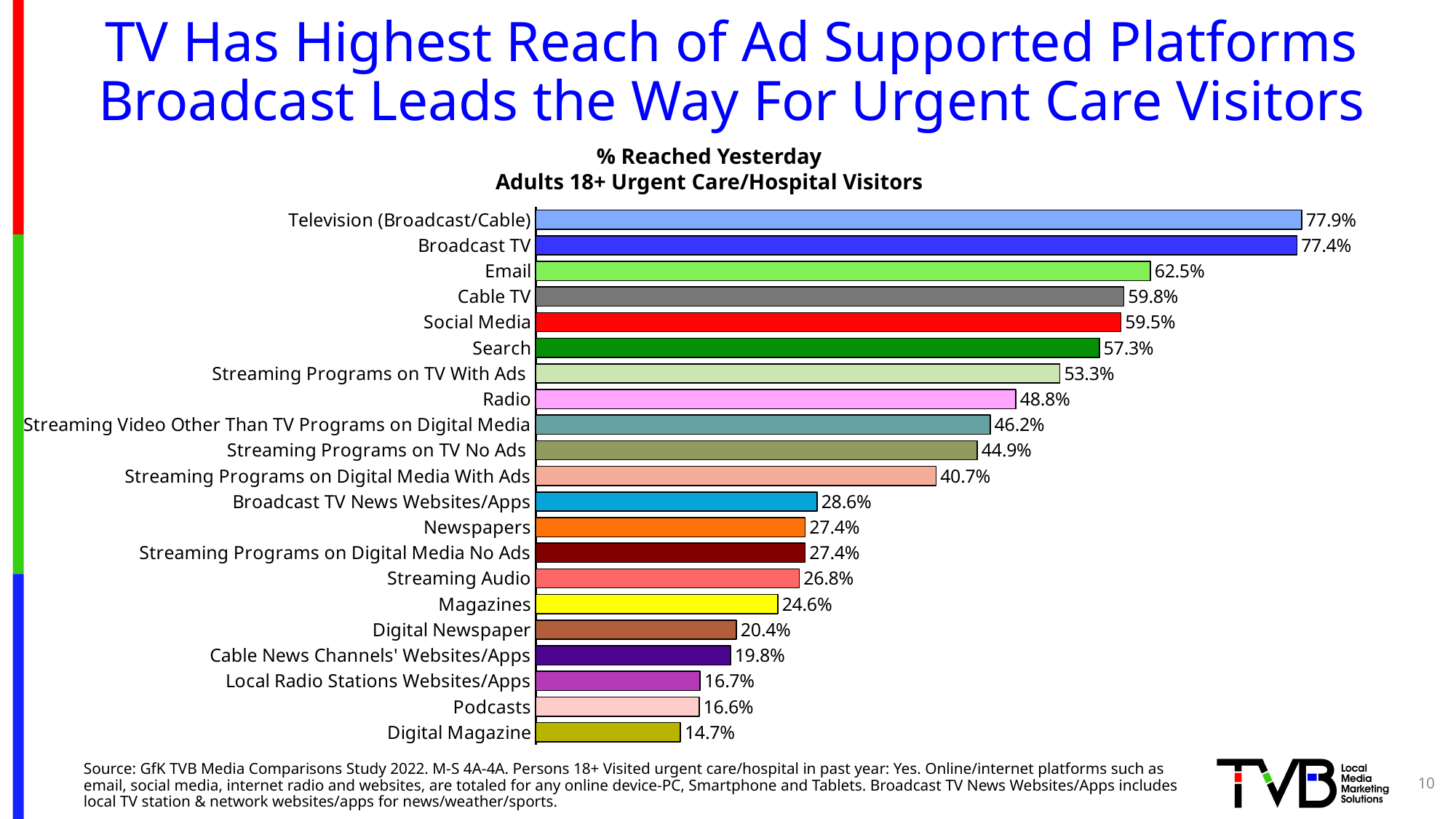
Which has a higher % reached yesterday, Streaming Audio or Broadcast TV News Websites/Apps? Broadcast TV News Websites/Apps What is the % reached yesterday for Radio? 48.8% How many categories are shown in the bar chart? 21 What is the difference in % reached between Social Media and Search? 2.2% What is the title of the chart? % Reached Yesterday Adults 18+ Urgent Care/Hospital Visitors Which has a higher % reached yesterday, Magazines or Digital Newspaper? Magazines Which category has the lowest % reached yesterday? Digital Magazine What is the % reached yesterday for Email? 62.5% Which category has the highest % reached yesterday? Television (Broadcast/Cable) What is the difference in % reached between Broadcast TV and Cable TV? 17.6% What is the % reached yesterday for Podcasts? 16.6% What type of chart is shown on the slide? Bar chart